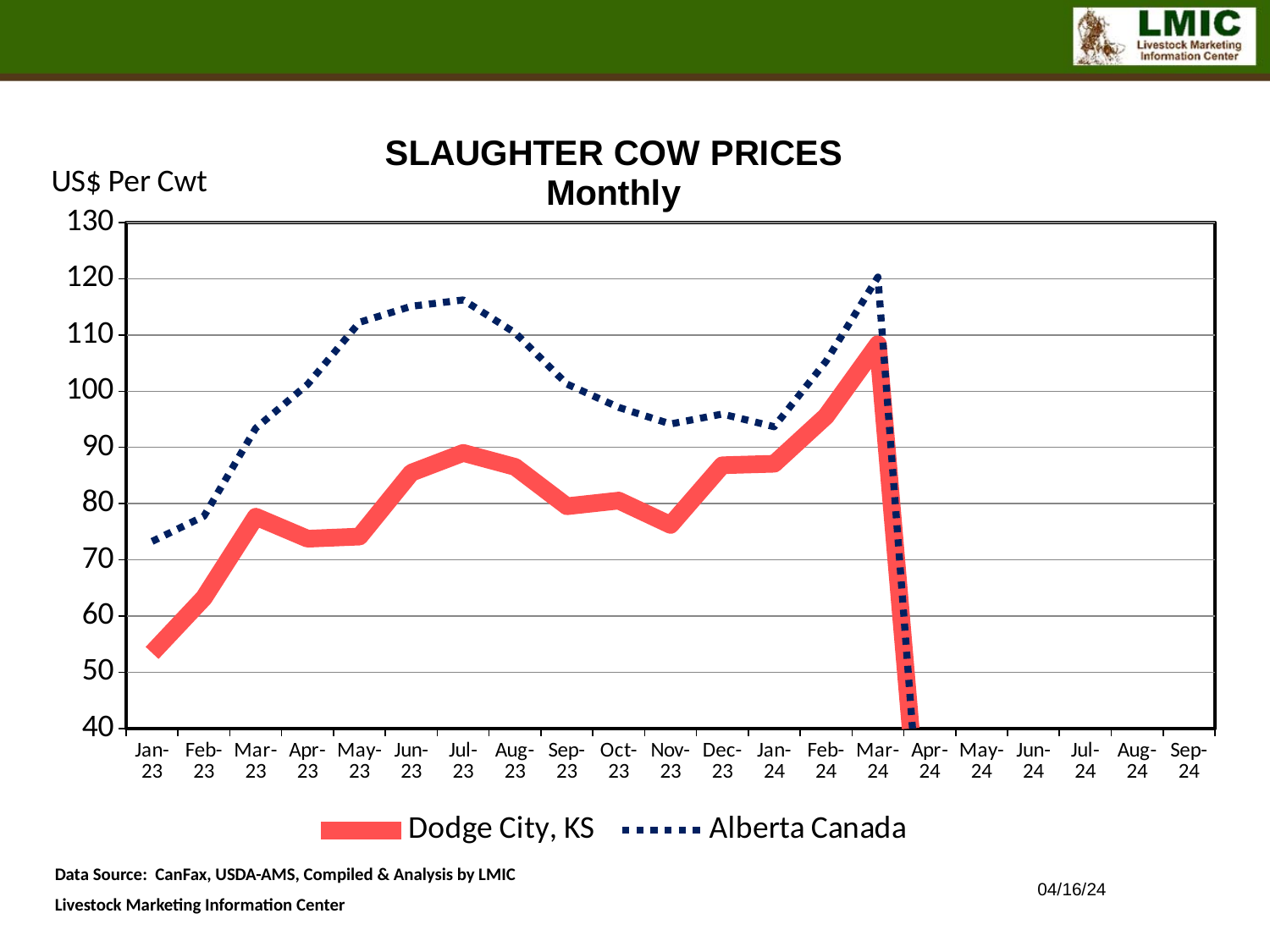
Is the Alberta Canada value for Nov-23 greater or less than 100? less How many series does the legend list? 2 Which two series are shown in the legend? Dodge City, KS and Alberta Canada In Jun-23, which series has the higher value, Dodge City, KS or Alberta Canada? Alberta Canada Do Dodge City, KS prices rise or fall from Jan-23 to Mar-23? rise Is the Alberta Canada value for Jul-23 greater or less than 110? greater Is the Dodge City, KS value for Jan-23 greater or less than 60? less What kind of chart is shown on the slide? line chart What is the y-axis unit label on the chart? US$ Per Cwt How many months are labeled along the x axis? 21